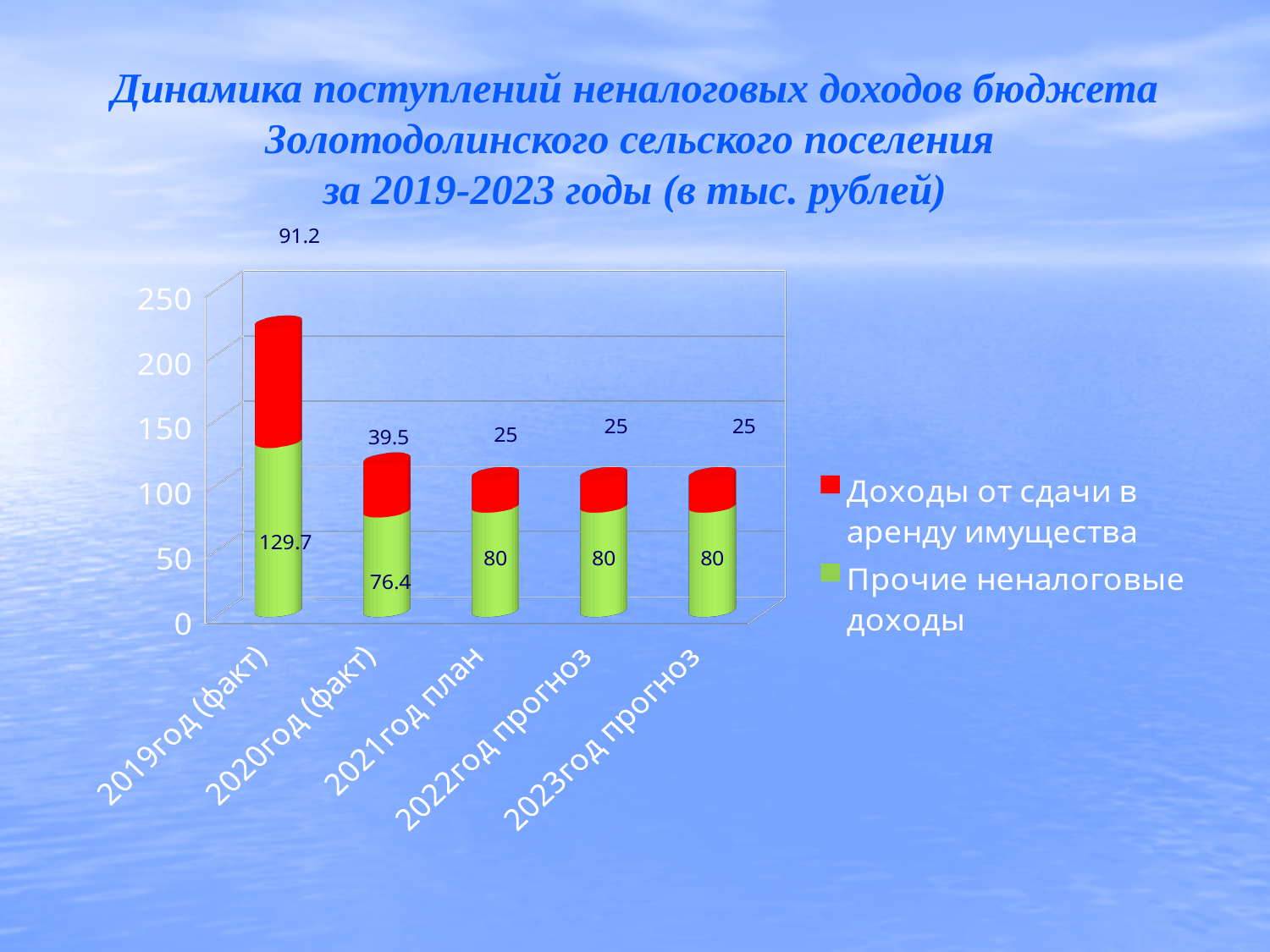
What is the value of 'Доходы от сдачи в аренду имущества' for 2020год (факт)? 39.5 Which category has the lowest value for 'Доходы от сдачи в аренду имущества' among the first two categories? 2020год (факт) Which series is shown in red in the legend? Доходы от сдачи в аренду имущества Which category has the highest value for 'Прочие неналоговые доходы'? 2019год (факт) What type of chart is shown on the slide? bar chart How many categories are shown on the x axis? 5 What is the value of 'Доходы от сдачи в аренду имущества' for 2022год прогноз? 25 What is the value of 'Прочие неналоговые доходы' for 2019год (факт)? 129.7 How many series does the legend list? 2 What is the total of the stacked bar for 2019год (факт)? 220.9 What is the difference between 'Прочие неналоговые доходы' for 2019год (факт) and 2020год (факт)? 53.3 What is the total of the stacked bar for 2021год план? 105